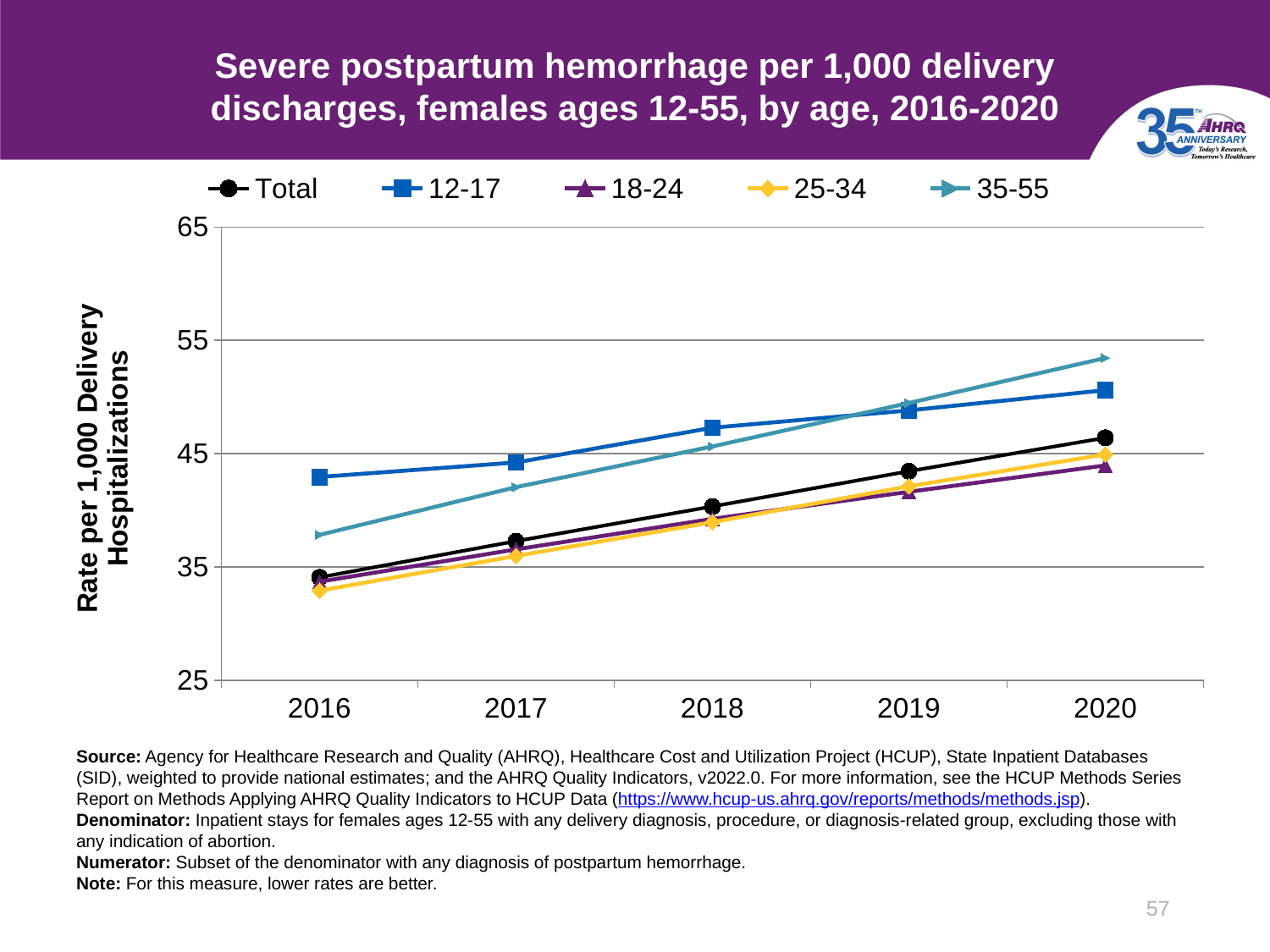
Is the value for the 12-17 age group in 2016 greater or less than 35? greater In 2017, which is larger: the rate for the 12-17 age group or the rate for the 25-34 age group? 12-17 Does the Total rate rise or fall from 2016 to 2020? rise How many series does the legend list? 5 How many years are plotted along the x axis? 5 Is the Total value in 2016 greater or less than 35? less Which age group has the highest rate in 2020? 35-55 What kind of chart is shown on the slide? line chart Is the value for the 35-55 age group in 2020 greater or less than 45? greater Does the rate for the 35-55 age group rise or fall from 2016 to 2020? rise What is the label on the y axis? Rate per 1,000 Delivery Hospitalizations Which age group has the highest rate in 2016? 12-17